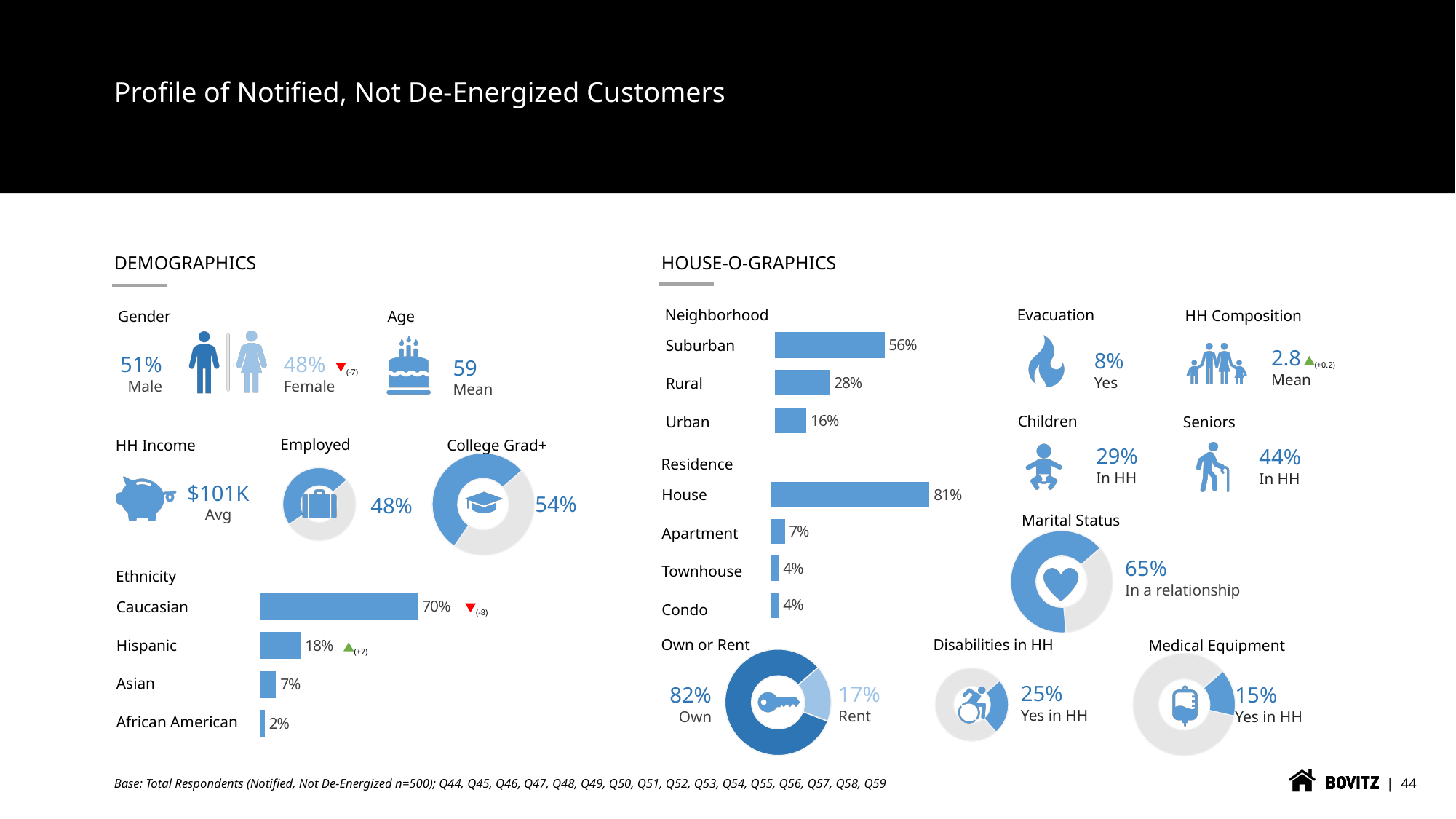
In the Ethnicity bar chart, what is the difference between the Hispanic and Asian values? 11% In the Ethnicity bar chart, what is the value for Caucasian? 70% In the Neighborhood bar chart, what is the difference between Suburban and Urban? 40% How many categories does the Ethnicity bar chart show? 4 What kind of chart is used for Marital Status? Donut chart In the Neighborhood bar chart, which category has the highest value? Suburban In the Residence bar chart, what is the value for House? 81% In the Neighborhood bar chart, what is the value for Rural? 28% In the Own or Rent donut chart, what share of respondents rent? 17% How many categories does the Residence bar chart show? 4 In the Residence bar chart, which is larger, Apartment or Townhouse? Apartment In the Ethnicity bar chart, which category has the lowest value? African American